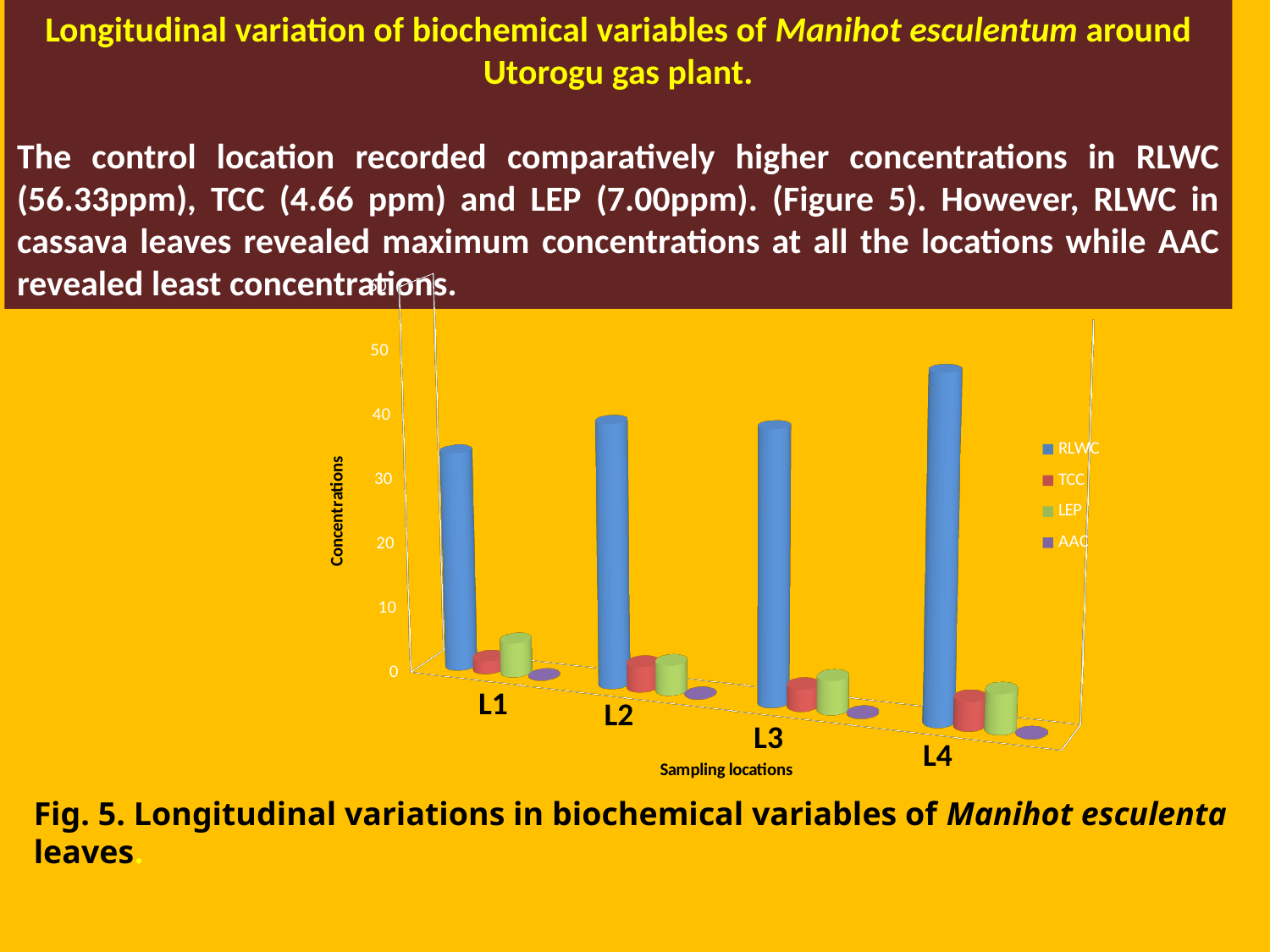
Is the RLWC value for L1 greater or less than 30? greater What kind of chart is shown on the slide? bar chart Which is larger, the RLWC value for L4 or the RLWC value for L1? L4 Which series has the tallest bar at every sampling location? RLWC Which series has the smallest bars at every sampling location? AAC At which sampling location is the RLWC bar highest? L4 How many sampling locations are shown on the x axis of the chart? 4 At which sampling location is the RLWC bar lowest? L1 Is the TCC value for L2 greater or less than 10? less Is the RLWC value for L4 greater or less than 40? greater How many series does the chart legend list? 4 What is the title of the vertical axis of the chart? Concentrations